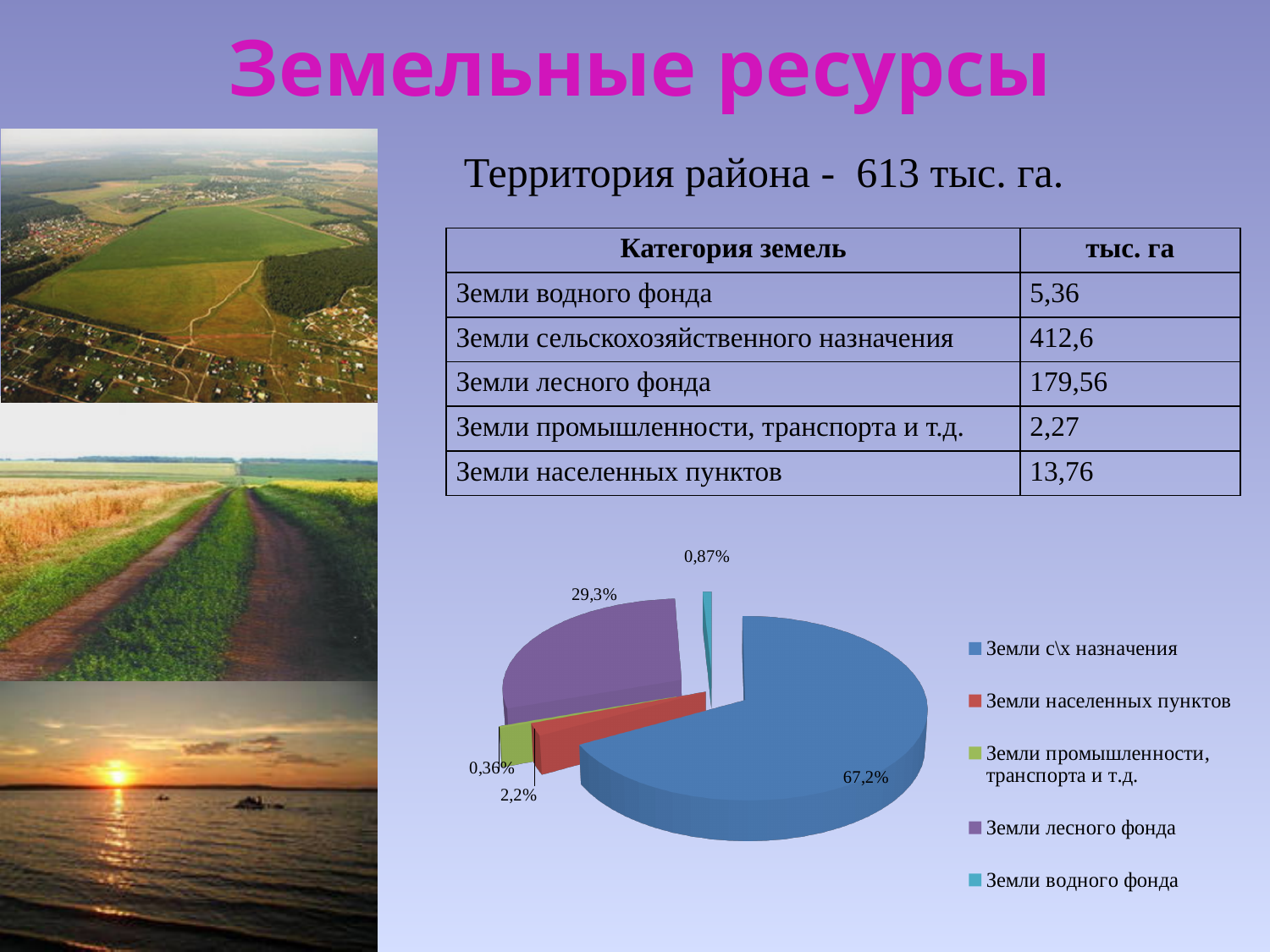
Which is larger in the pie chart: Земли лесного фонда or Земли населенных пунктов? Земли лесного фонда How many slices does the pie chart have? 5 Which category has the largest slice of the pie chart? Земли с\х назначения How many entries does the pie chart legend list? 5 What colour is the slice for Земли лесного фонда in the pie chart? purple What share of the pie does Земли лесного фонда have? 29,3% What share of the pie does Земли промышленности, транспорта и т.д. have? 0,36% What share of the pie does Земли населенных пунктов have? 2,2% Which category has the smallest slice of the pie chart? Земли промышленности, транспорта и т.д. What type of chart is shown on the slide? pie chart